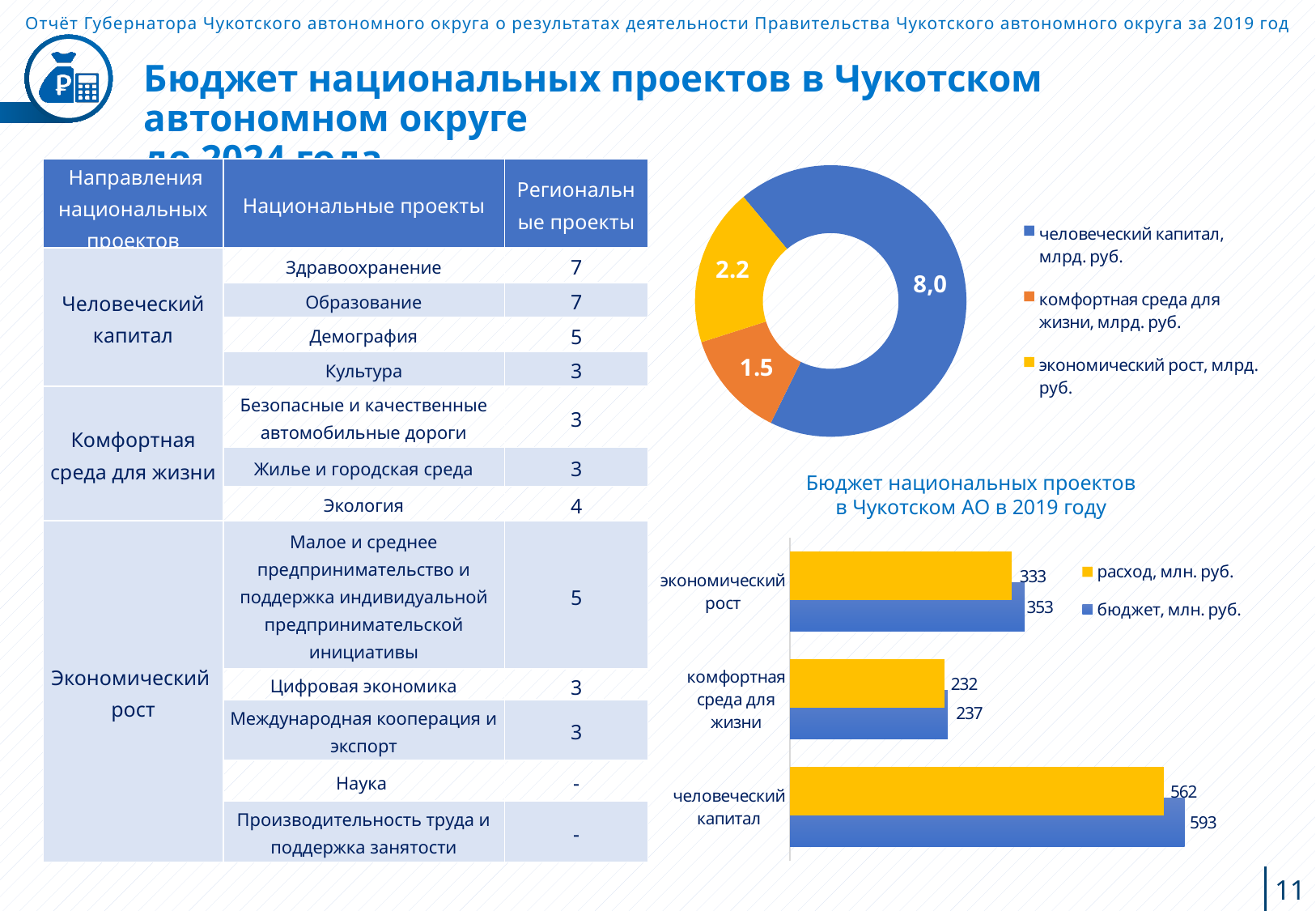
In the chart 'Бюджет национальных проектов в Чукотском АО в 2019 году', which has the larger расход value: экономический рост or комфортная среда для жизни? экономический рост In the pie chart at the top right, what is the value for человеческий капитал? 8,0 What kind of chart is the chart at the top right of the slide? doughnut chart In the chart 'Бюджет национальных проектов в Чукотском АО в 2019 году', what is the difference between бюджет and расход for экономический рост? 20 In the chart 'Бюджет национальных проектов в Чукотском АО в 2019 году', what is the расход value for комфортная среда для жизни? 232 In the pie chart at the top right, which category has the largest value? человеческий капитал In the pie chart at the top right, what is the value for экономический рост? 2.2 In the chart 'Бюджет национальных проектов в Чукотском АО в 2019 году', how many series does the legend list? 2 In the pie chart at the top right, which category has the smallest value? комфортная среда для жизни In the chart 'Бюджет национальных проектов в Чукотском АО в 2019 году', what is the difference between бюджет and расход for человеческий капитал? 31 In the chart 'Бюджет национальных проектов в Чукотском АО в 2019 году', how many categories are shown? 3 In the chart 'Бюджет национальных проектов в Чукотском АО в 2019 году', what is the бюджет value for человеческий капитал? 593